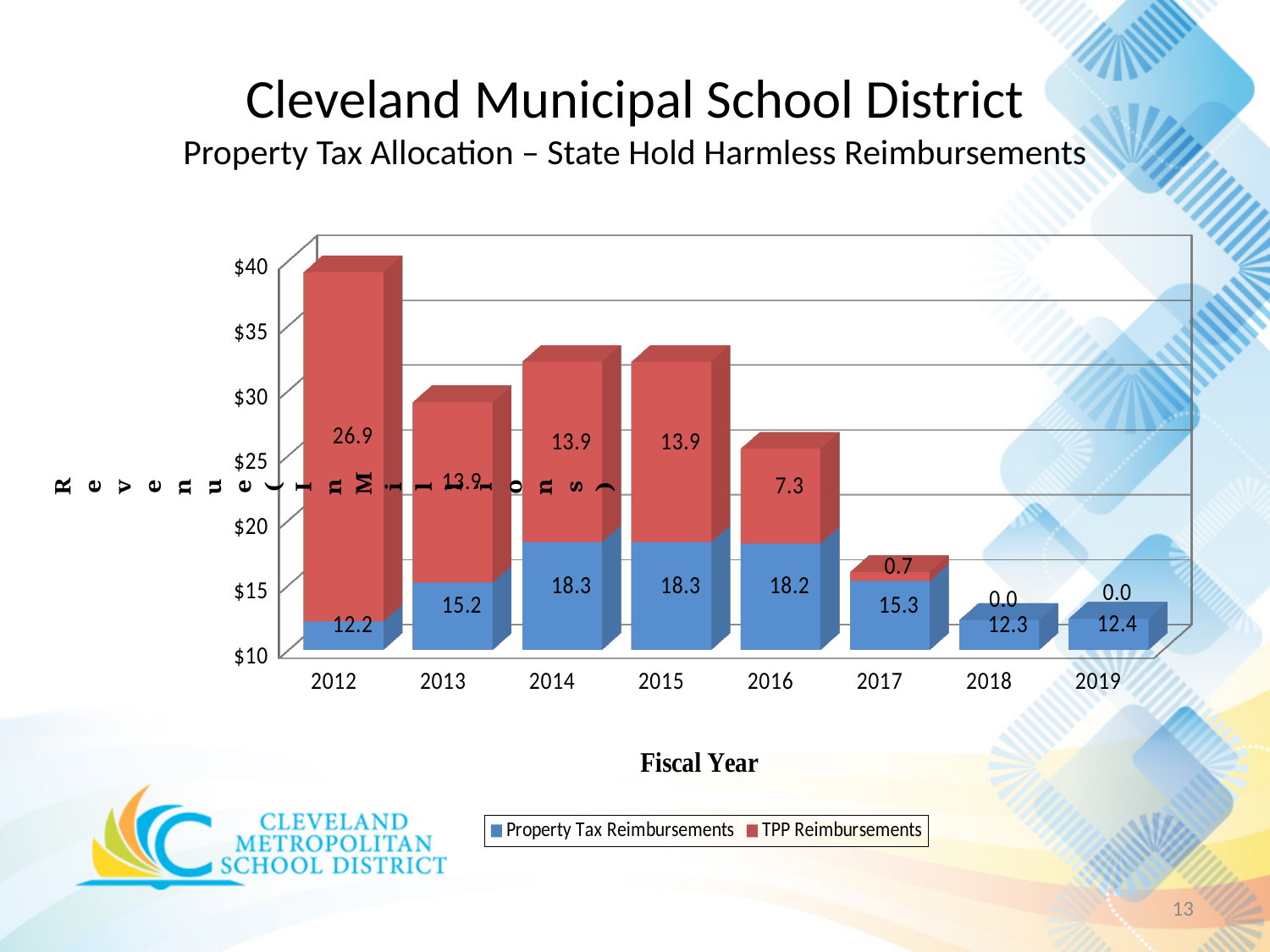
How many series does the legend list? 2 What is the value of TPP Reimbursements for 2012? 26.9 What is the difference between TPP Reimbursements in 2012 and 2013? 13.0 Which series is shown in red in the legend? TPP Reimbursements What type of chart is shown on the slide? Stacked bar chart Which fiscal year has the lowest Property Tax Reimbursements value? 2012 How many fiscal years are shown on the x axis? 8 Which is larger, Property Tax Reimbursements in 2013 or in 2017? 2017 Which fiscal year has the highest TPP Reimbursements value? 2012 What is the value of Property Tax Reimbursements for 2016? 18.2 What is the value of TPP Reimbursements for 2017? 0.7 What is the total of the stacked bar for 2016? 25.5